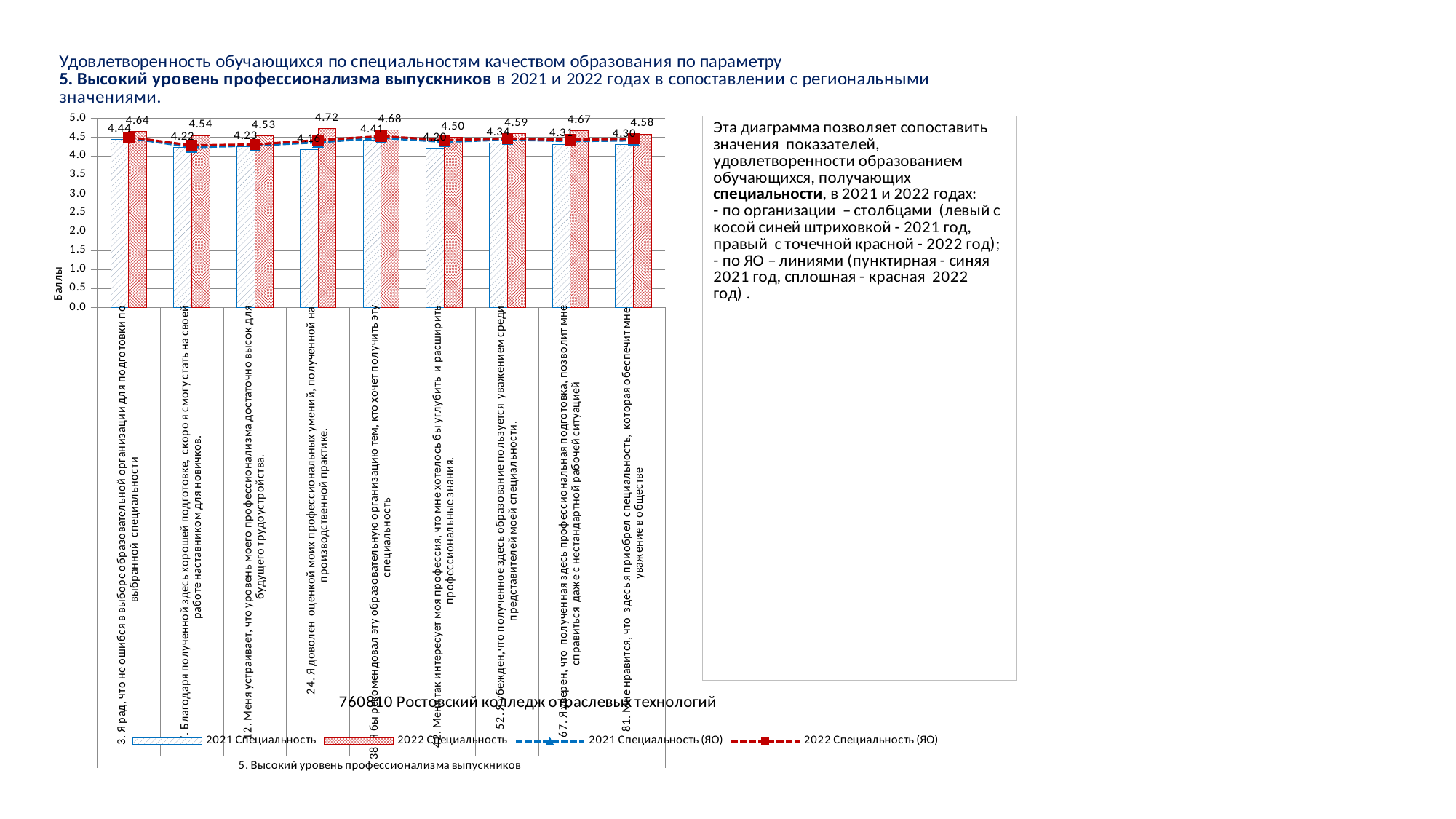
Is the 2021 Специальность value for the second category greater or less than 4.0? greater How many series does the legend list? 4 For the last category (item 81), which is larger: the 2021 value (4.30) or the 2022 value (4.58)? 2022 (4.58) What is the 2022 Специальность value for the first category (item 3, 'Я рад, что не ошибся в выборе образовательной организации...')? 4.64 How many categories (questionnaire items) are plotted on the chart? 9 Which category has the highest 2022 Специальность value? 24. Я доволен оценкой моих профессиональных умений, полученной на производственной практике (4.72) What kind of chart is used for the 2021 and 2022 Специальность series? bar chart What is the 2022 Специальность value for item 24 ('Я доволен оценкой моих профессиональных умений...')? 4.72 What is the 2021 Специальность value for the first category (item 3)? 4.44 What is the lowest 2022 Специальность value shown on the chart? 4.50 What is the 2022 Специальность value for the last category (item 81, 'Мне нравится, что здесь я приобрел специальность...')? 4.58 What is the difference between the 2022 and 2021 Специальность values for the first category (item 3)? 0.20